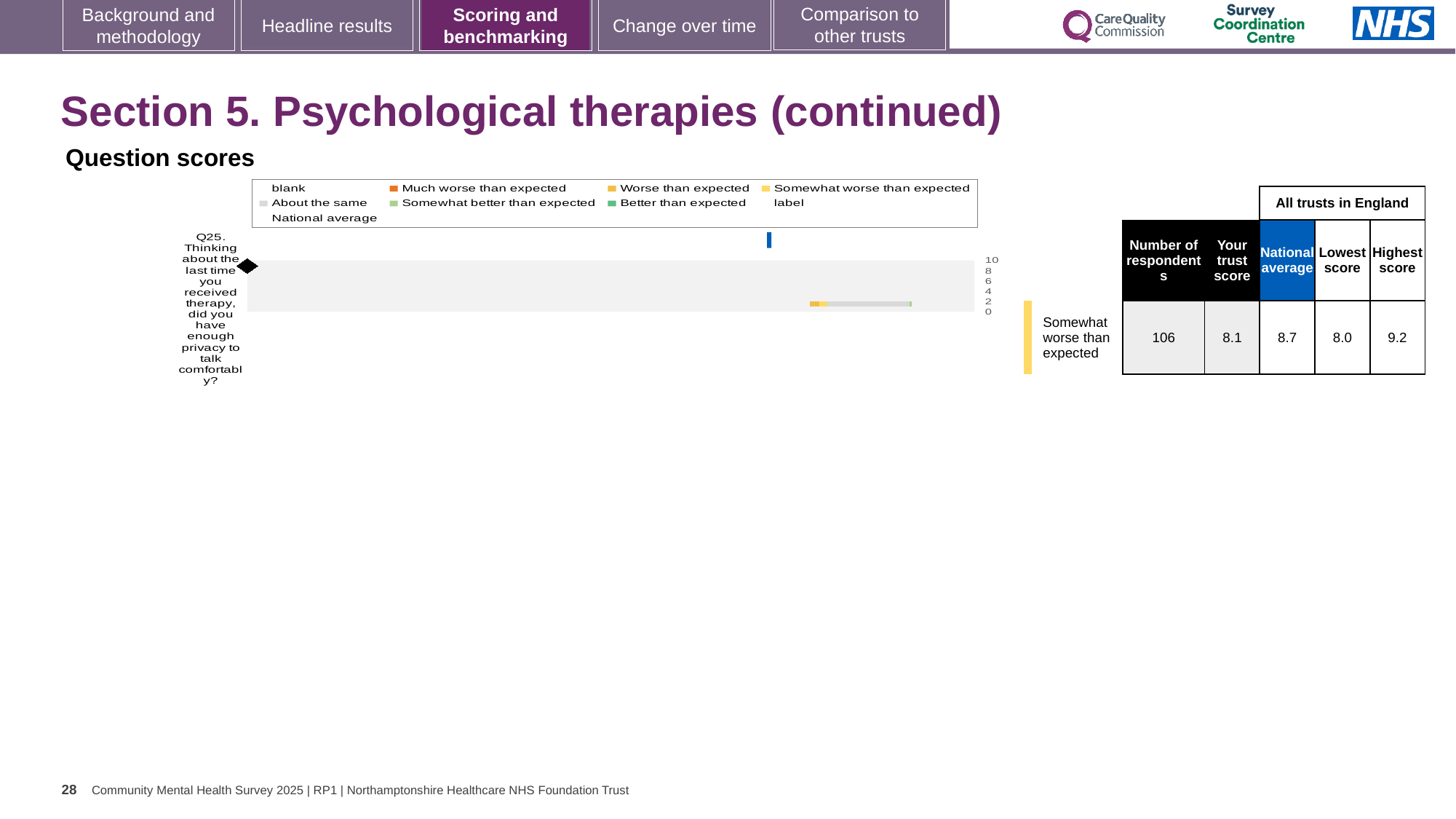
In the table beside the Question scores chart, which is larger for Q25: the trust's score or the national average? national average In the table beside the Question scores chart, what is the lowest score among all trusts in England for Q25? 8.0 Which legend entry in the Question scores chart is shown in orange? Much worse than expected In the table beside the Question scores chart, what is the national average for Q25? 8.7 In the table beside the Question scores chart, what is the trust's score for Q25? 8.1 How many questions (categories) are plotted in the Question scores chart? 1 In the table beside the Question scores chart, what is the difference between the highest score and the lowest score for Q25? 1.2 Which question is plotted in the Question scores chart? Q25. Thinking about the last time you received therapy, did you have enough privacy to talk comfortably? In the table beside the Question scores chart, what is the highest score among all trusts in England for Q25? 9.2 What benchmark category label is given for Q25 next to the table? Somewhat worse than expected What kind of chart is shown under "Question scores"? bar chart In the table beside the Question scores chart, what is the number of respondents for Q25? 106